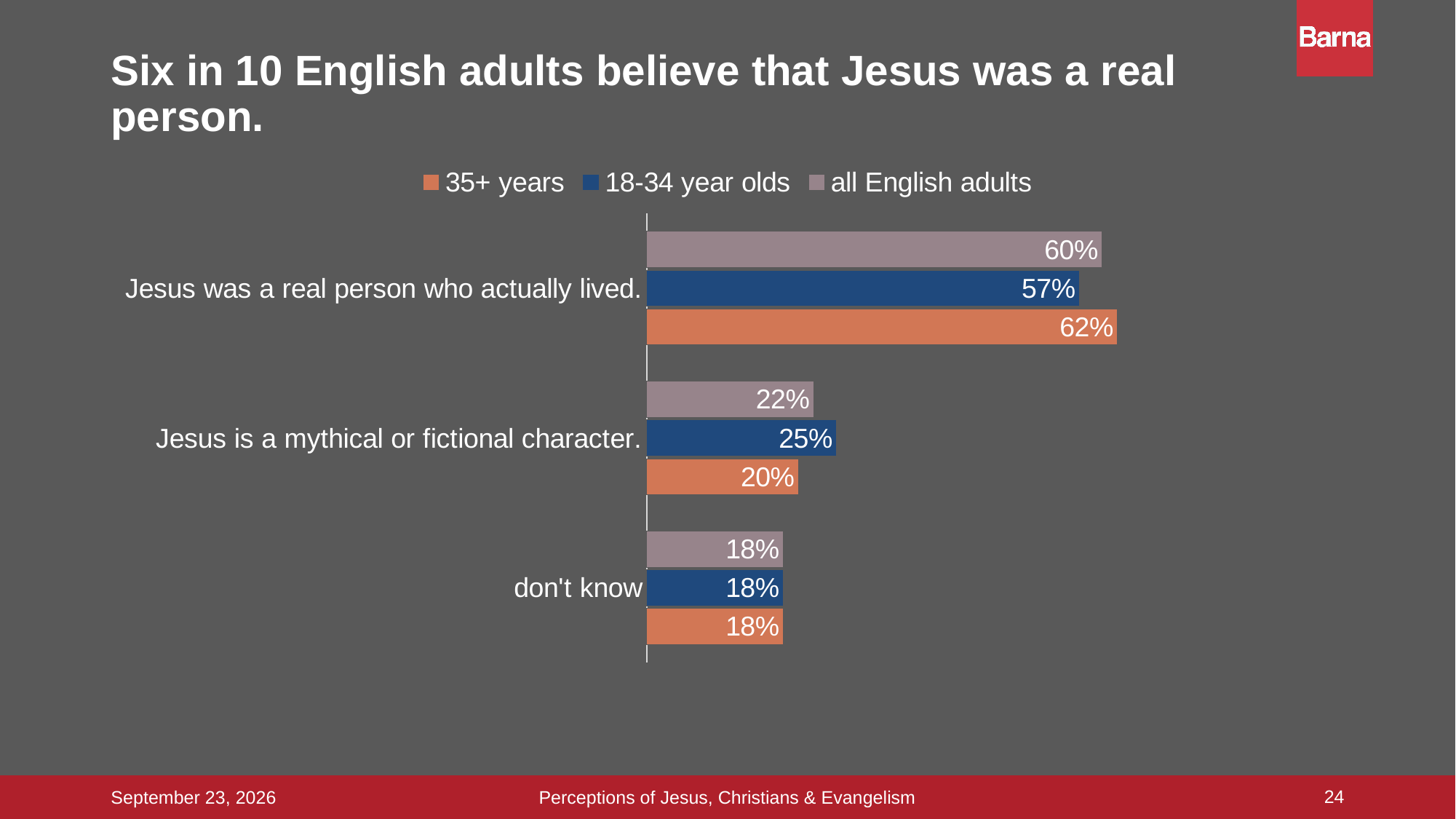
Which category has the highest value for 18-34 year olds? Jesus was a real person who actually lived. How many categories are shown on the chart? 3 What percentage of 35+ years respondents say Jesus was a real person who actually lived? 62% Which group has a larger value for 'Jesus is a mythical or fictional character': 35+ years or 18-34 year olds? 18-34 year olds How many series does the legend list? 3 What percentage of all English adults say Jesus was a real person who actually lived? 60% What percentage of 35+ years respondents answered 'don't know'? 18% What is the difference between the 35+ years and 18-34 year olds values for 'Jesus was a real person who actually lived'? 5% Which category has the lowest value for all English adults? don't know What percentage of 18-34 year olds say Jesus is a mythical or fictional character? 25% What kind of chart is shown on the slide? Bar chart Which series is shown in orange in the legend? 35+ years